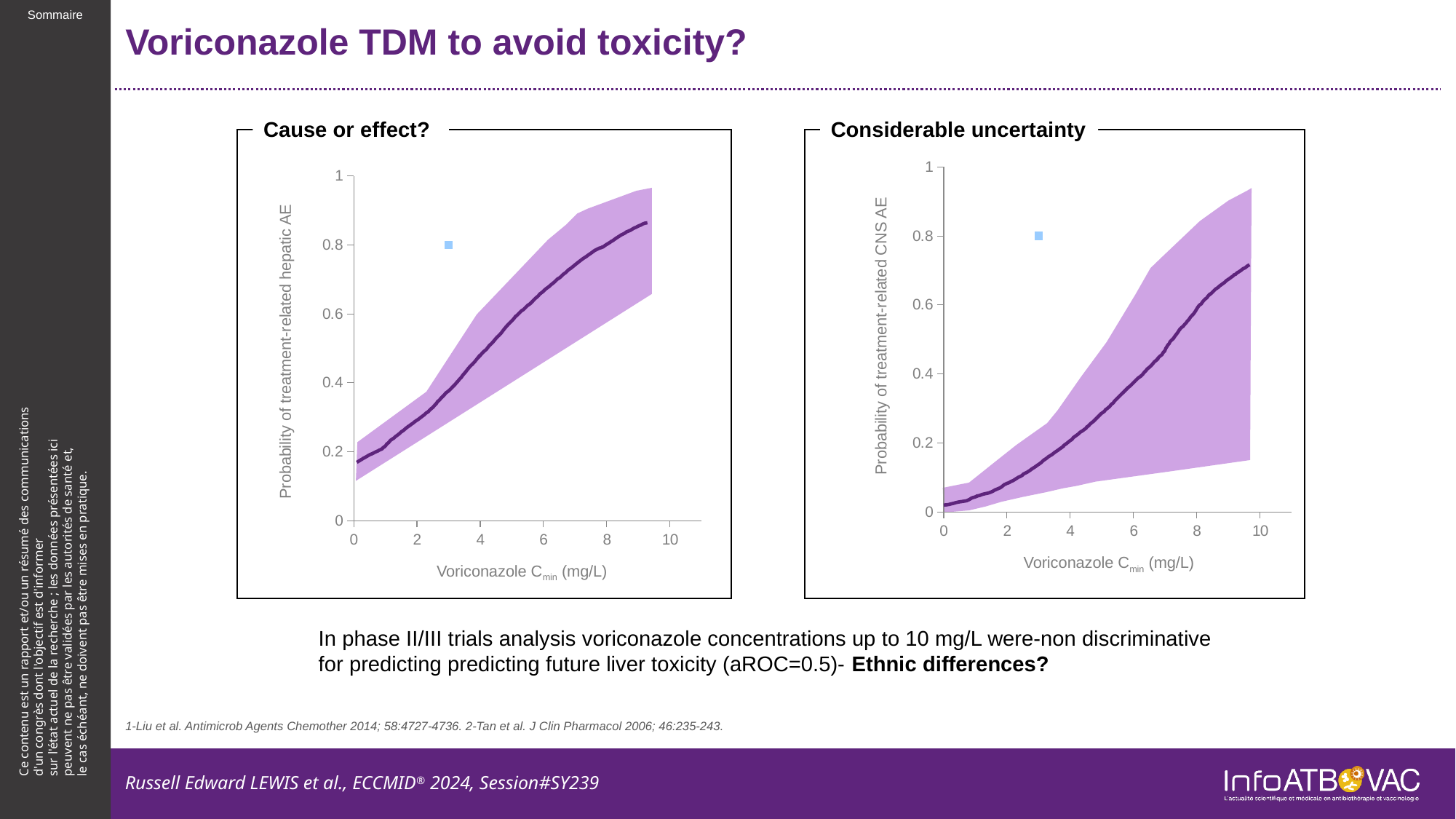
In the 'Considerable uncertainty' chart, is the probability of CNS AE at a voriconazole Cmin of 4 mg/L greater or less than 0.2? less In the 'Considerable uncertainty' chart, does the probability of treatment-related CNS AE rise or fall as voriconazole Cmin increases? rise What is the x-axis label of the 'Cause or effect?' chart? Voriconazole Cmin (mg/L) How many charts are shown on the slide? 2 In the 'Cause or effect?' chart, is the probability of hepatic AE at a voriconazole Cmin of 0 mg/L greater or less than 0.2? less What is the y-axis label of the 'Considerable uncertainty' chart? Probability of treatment-related CNS AE In the 'Considerable uncertainty' chart, is the probability of CNS AE at a voriconazole Cmin of 6 mg/L greater or less than 0.4? less What kind of chart is the 'Cause or effect?' chart on the left? line chart In the 'Cause or effect?' chart, does the probability of treatment-related hepatic AE rise or fall as voriconazole Cmin increases? rise At a voriconazole Cmin of 4 mg/L, which chart shows the higher probability of a treatment-related AE: 'Cause or effect?' (hepatic) or 'Considerable uncertainty' (CNS)? Cause or effect? (hepatic)